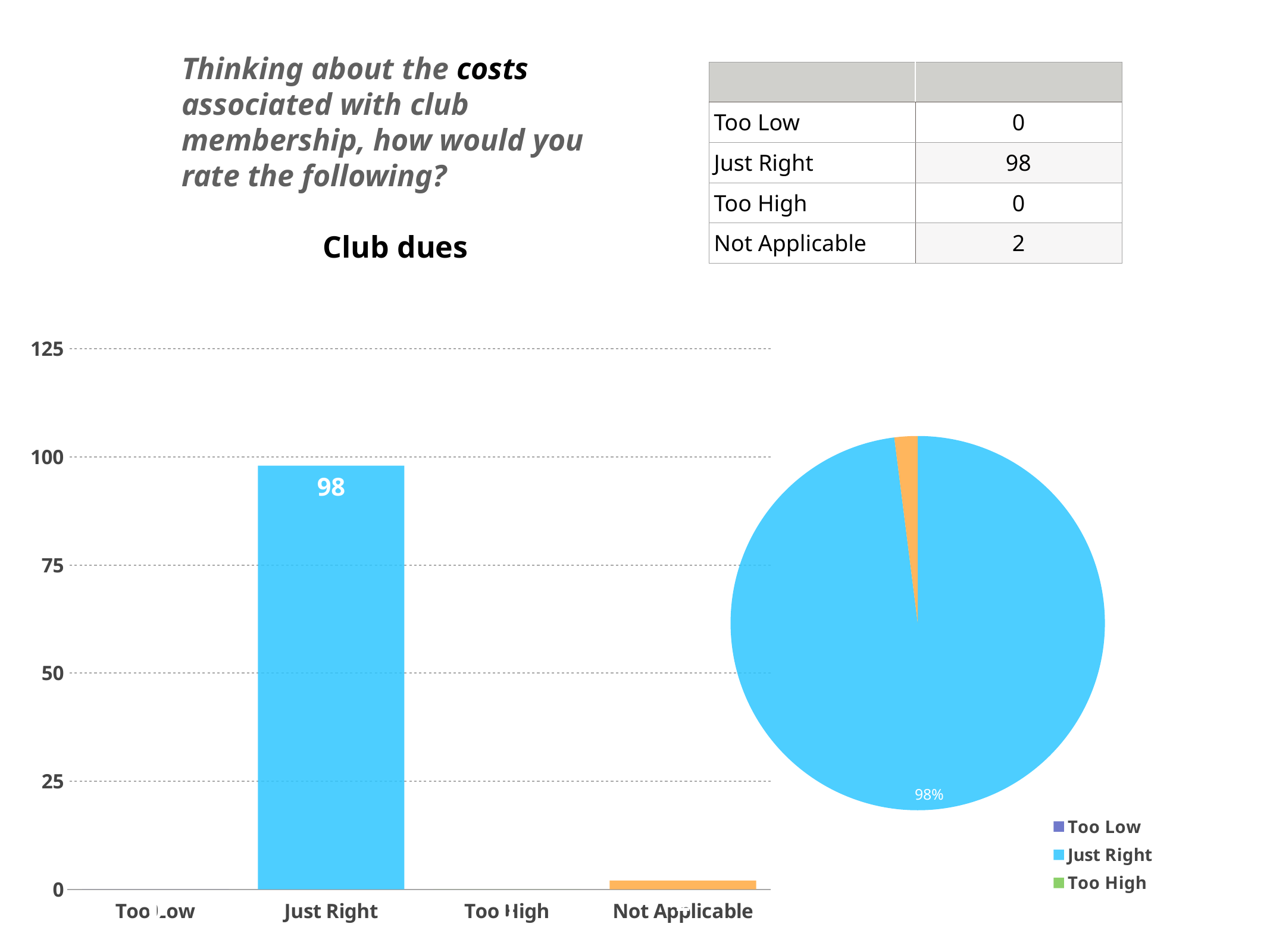
On the bar chart titled Club dues, which category has the highest value? Just Right On the bar chart titled Club dues, is the value for Just Right greater or less than 75? greater On the bar chart titled Club dues, which is larger, the value for Just Right or the value for Not Applicable? Just Right On the bar chart titled Club dues, is the value for Not Applicable greater or less than 25? less On the pie chart on the right, what share of the pie is labelled for the Just Right slice? 98% On the pie chart on the right, what colour is the Just Right slice? blue On the bar chart titled Club dues, what is the value for Just Right? 98 What kind of chart is the chart on the right of the slide? pie chart What is the title of the bar chart on the left of the slide? Club dues On the pie chart on the right, how many entries does the legend list? 3 What kind of chart is the chart on the left of the slide? bar chart On the bar chart titled Club dues, how many categories are shown on the x axis? 4